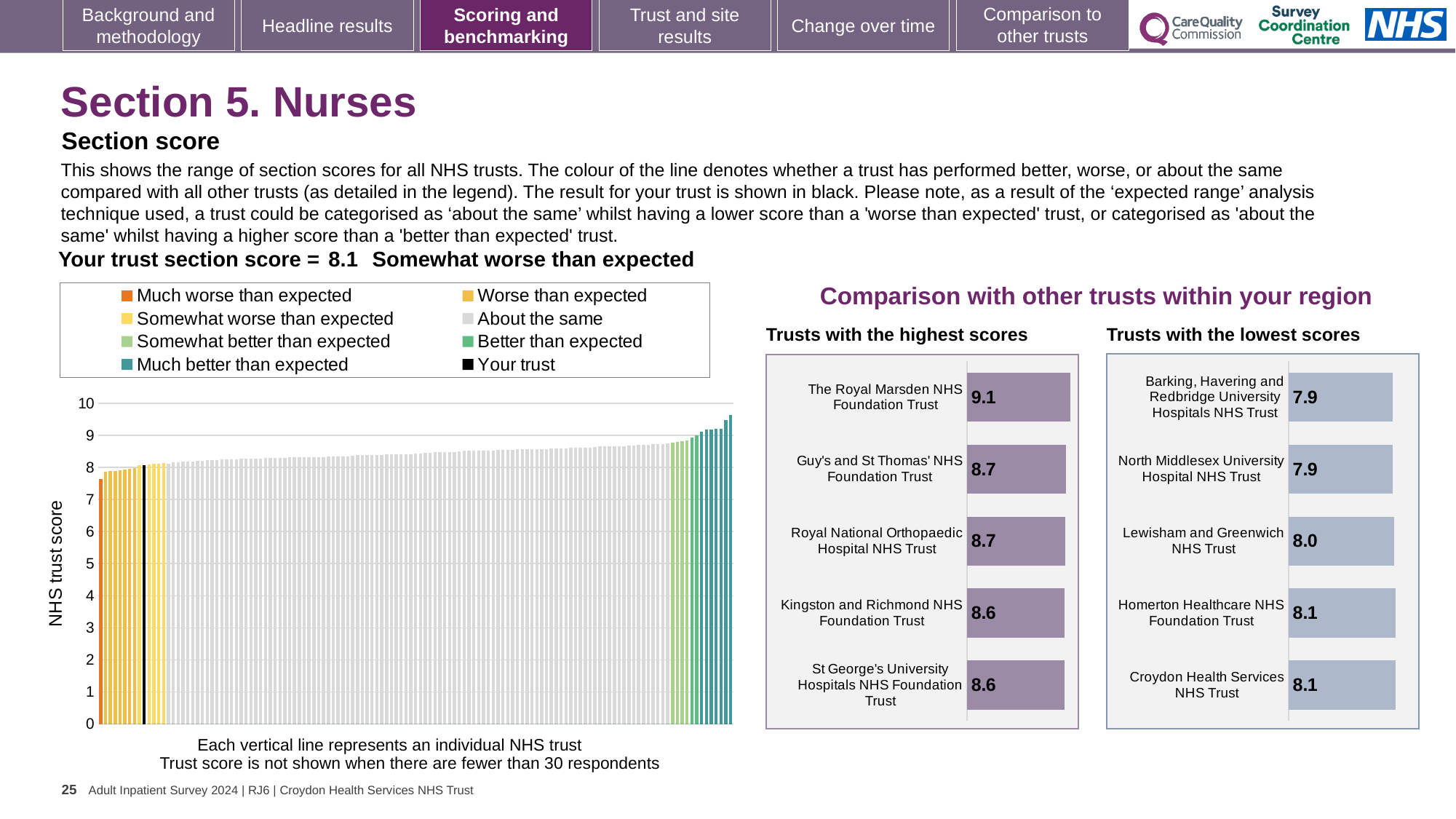
In the 'Trusts with the highest scores' chart, which trust has the highest score? The Royal Marsden NHS Foundation Trust In the main NHS trust score chart, do the values rise or fall from left to right? Rise In the 'Trusts with the highest scores' chart, which has the larger score: Royal National Orthopaedic Hospital NHS Trust or Kingston and Richmond NHS Foundation Trust? Royal National Orthopaedic Hospital NHS Trust In the main NHS trust score chart, what colour is used to show your trust? Black How many entries does the legend of the main NHS trust score chart list? 8 In the 'Trusts with the lowest scores' chart, what is the score for Lewisham and Greenwich NHS Trust? 8.0 In the main NHS trust score chart, is the value of the tallest bar greater or less than 9? greater What kind of chart is the main chart showing NHS trust scores on the left of the slide? Bar chart In the 'Trusts with the highest scores' chart, what is the difference between the scores of The Royal Marsden NHS Foundation Trust and Guy's and St Thomas' NHS Foundation Trust? 0.4 In the 'Trusts with the highest scores' chart, what is the score for The Royal Marsden NHS Foundation Trust? 9.1 How many trusts are shown in the 'Trusts with the lowest scores' chart? 5 In the 'Trusts with the lowest scores' chart, what is the difference between the scores of Croydon Health Services NHS Trust and Barking, Havering and Redbridge University Hospitals NHS Trust? 0.2